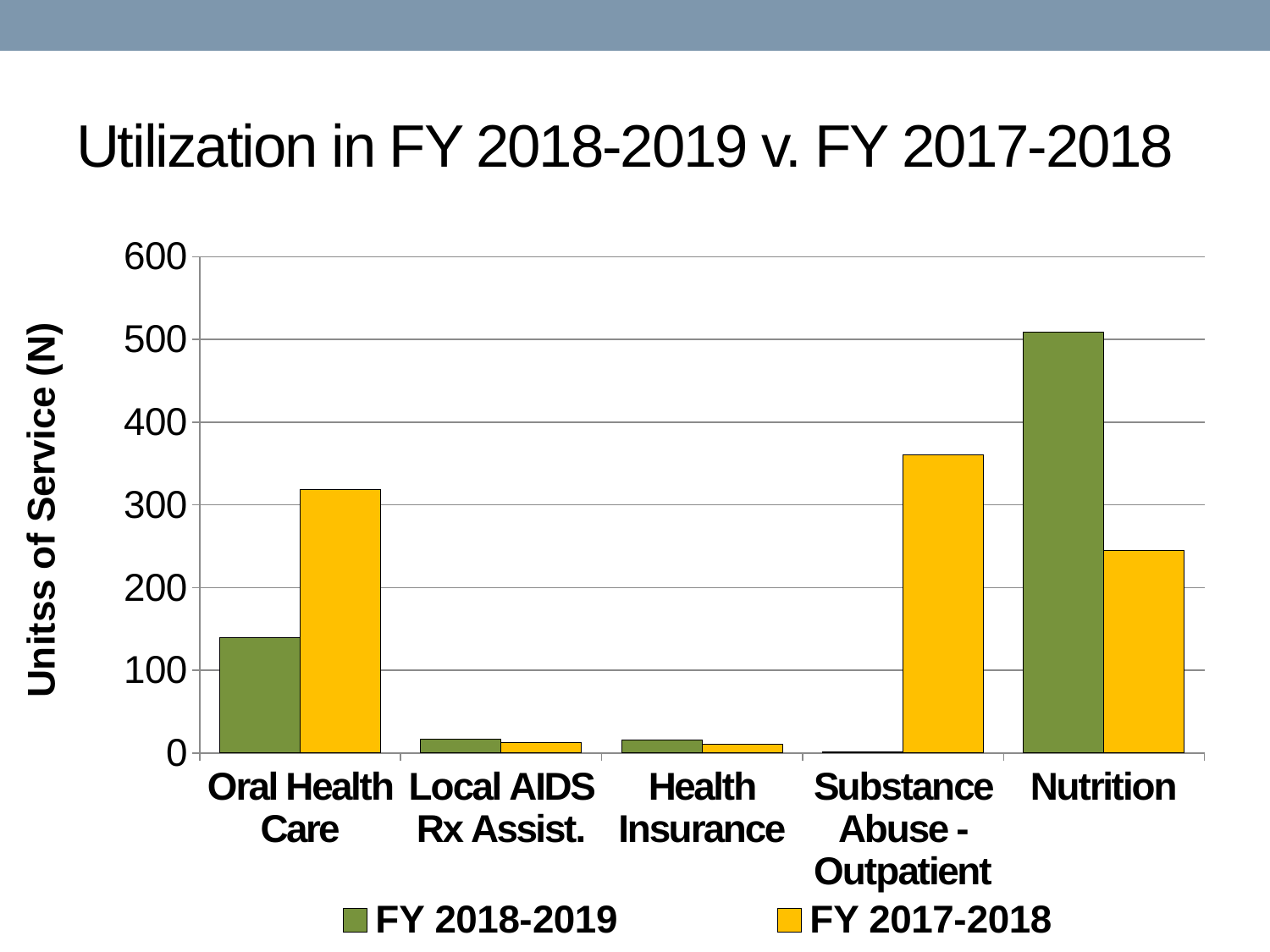
Which category has the lowest value for FY 2018-2019? Substance Abuse - Outpatient For Nutrition, which series has the larger value, FY 2018-2019 or FY 2017-2018? FY 2018-2019 How many series does the legend list? 2 Is the FY 2018-2019 value for Oral Health Care greater or less than 200? less What is the title of the chart's vertical axis? Unitss of Service (N) What kind of chart is shown on the slide? bar chart For Oral Health Care, which series has the larger value, FY 2018-2019 or FY 2017-2018? FY 2017-2018 How many categories are shown on the x axis of the chart? 5 Is the FY 2018-2019 value for Nutrition greater or less than 400? greater Is the FY 2017-2018 value for Nutrition greater or less than 300? less Which category has the highest value for FY 2018-2019? Nutrition Which category has the highest value for FY 2017-2018? Substance Abuse - Outpatient